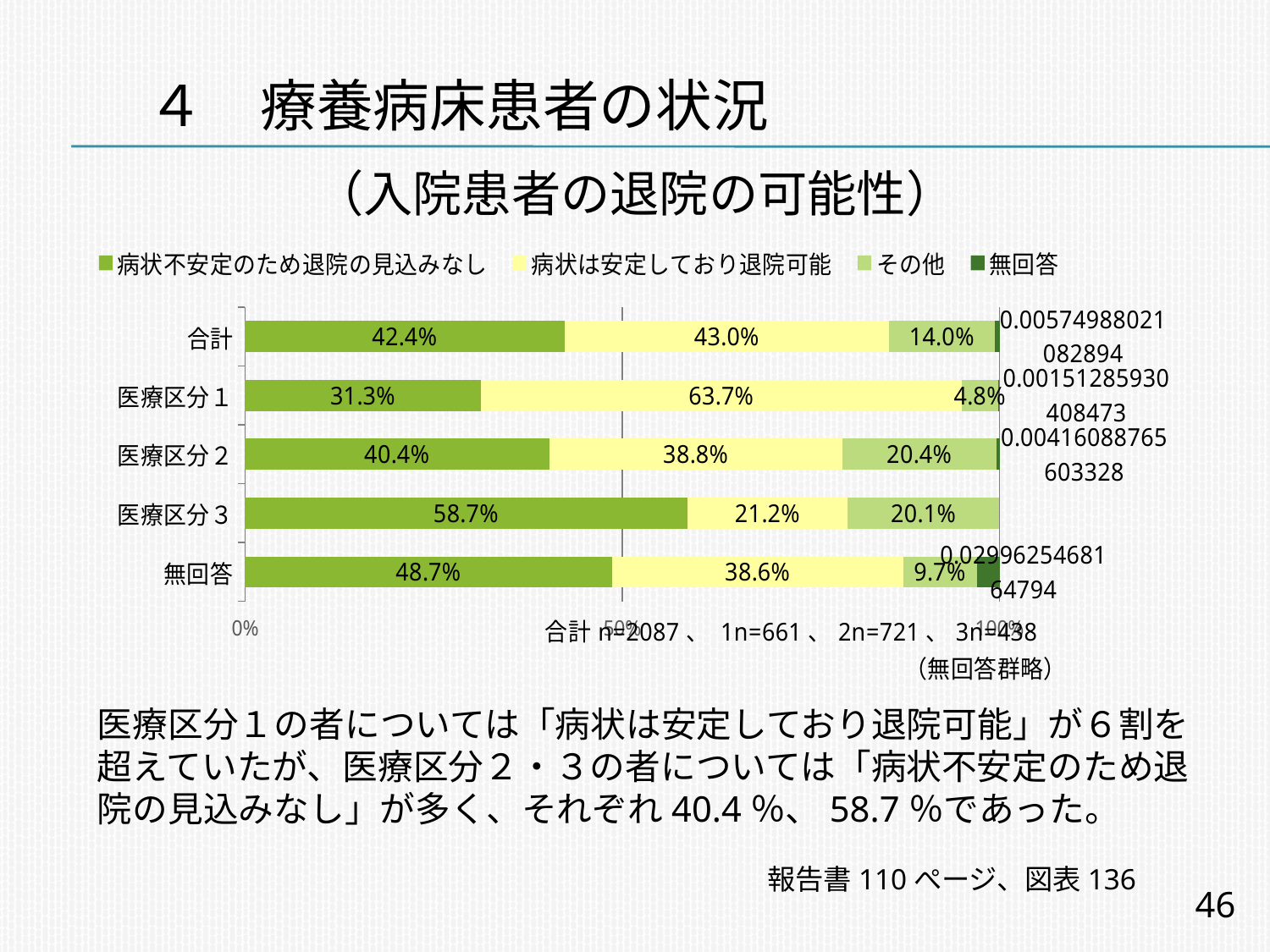
What is the value of 病状不安定のため退院の見込みなし for 合計? 42.4% Which category has the lowest value for その他? 医療区分１ How many series does the legend list? 4 Which legend entry is shown in the darkest green colour? 無回答 What is the value of 病状不安定のため退院の見込みなし for 無回答? 48.7% How many categories are shown on the vertical axis of the chart? 5 What is the difference between the 病状不安定のため退院の見込みなし values for 医療区分３ and 医療区分１? 27.4 percentage points What is the value of 病状は安定しており退院可能 for 医療区分１? 63.7% For 無回答, which is larger: 病状不安定のため退院の見込みなし or 病状は安定しており退院可能? 病状不安定のため退院の見込みなし Which category has the highest value for 病状不安定のため退院の見込みなし? 医療区分３ What is the value of その他 for 医療区分２? 20.4% What kind of chart is shown on the slide? Stacked bar chart